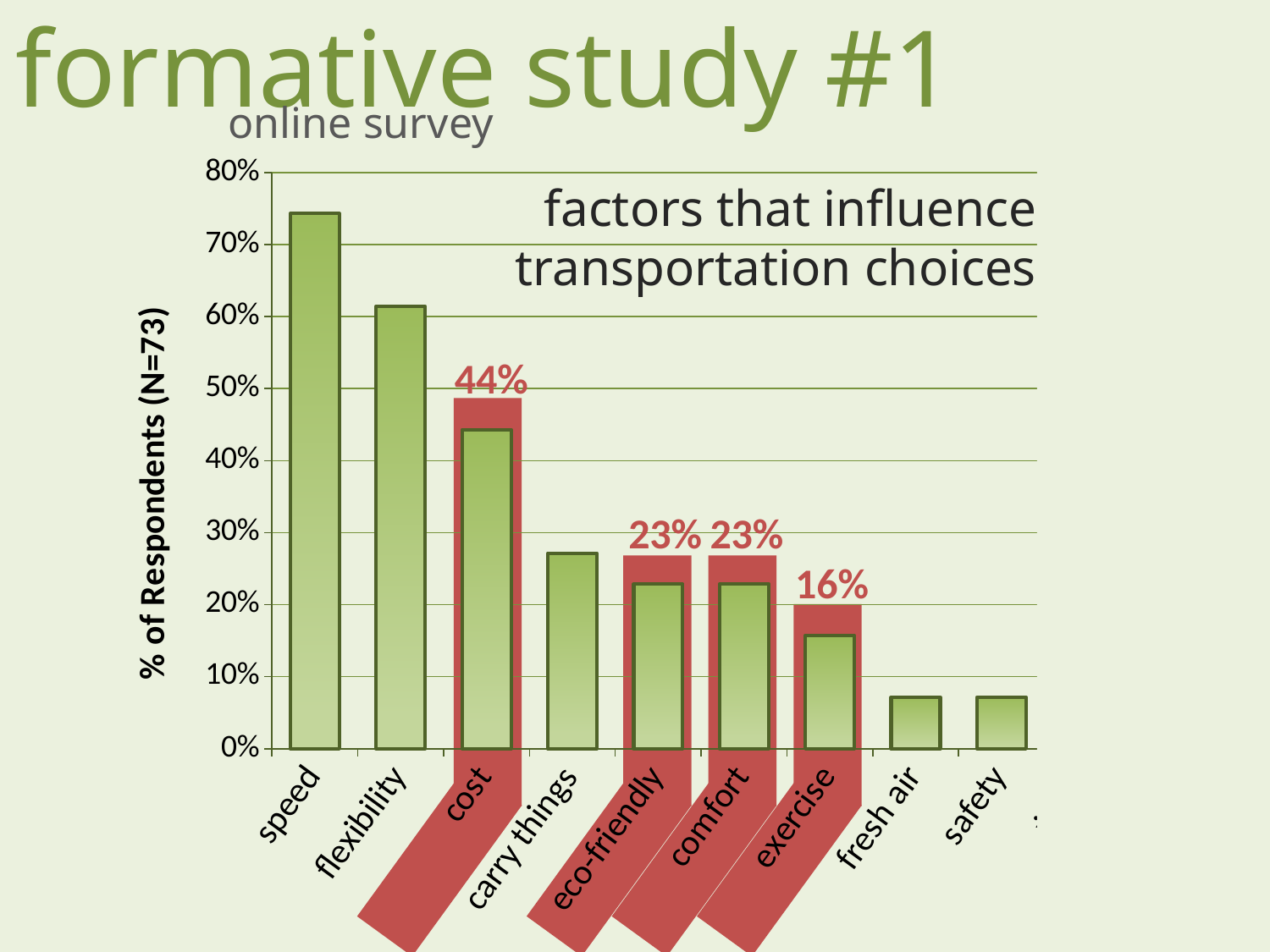
What is the value for eco-friendly? 23% Which is larger, the value for speed or the value for flexibility? speed Is the value for fresh air greater or less than 10%? less What is the difference between the values for comfort and exercise? 7% How many categories are shown on the x axis? 9 Which category has the highest value? speed What is the value for exercise? 16% Is the value for speed greater or less than 70%? greater What is the difference between the values for cost and exercise? 28% What kind of chart is shown on the slide? bar chart What is the label on the vertical axis? % of Respondents (N=73) What is the value for cost? 44%